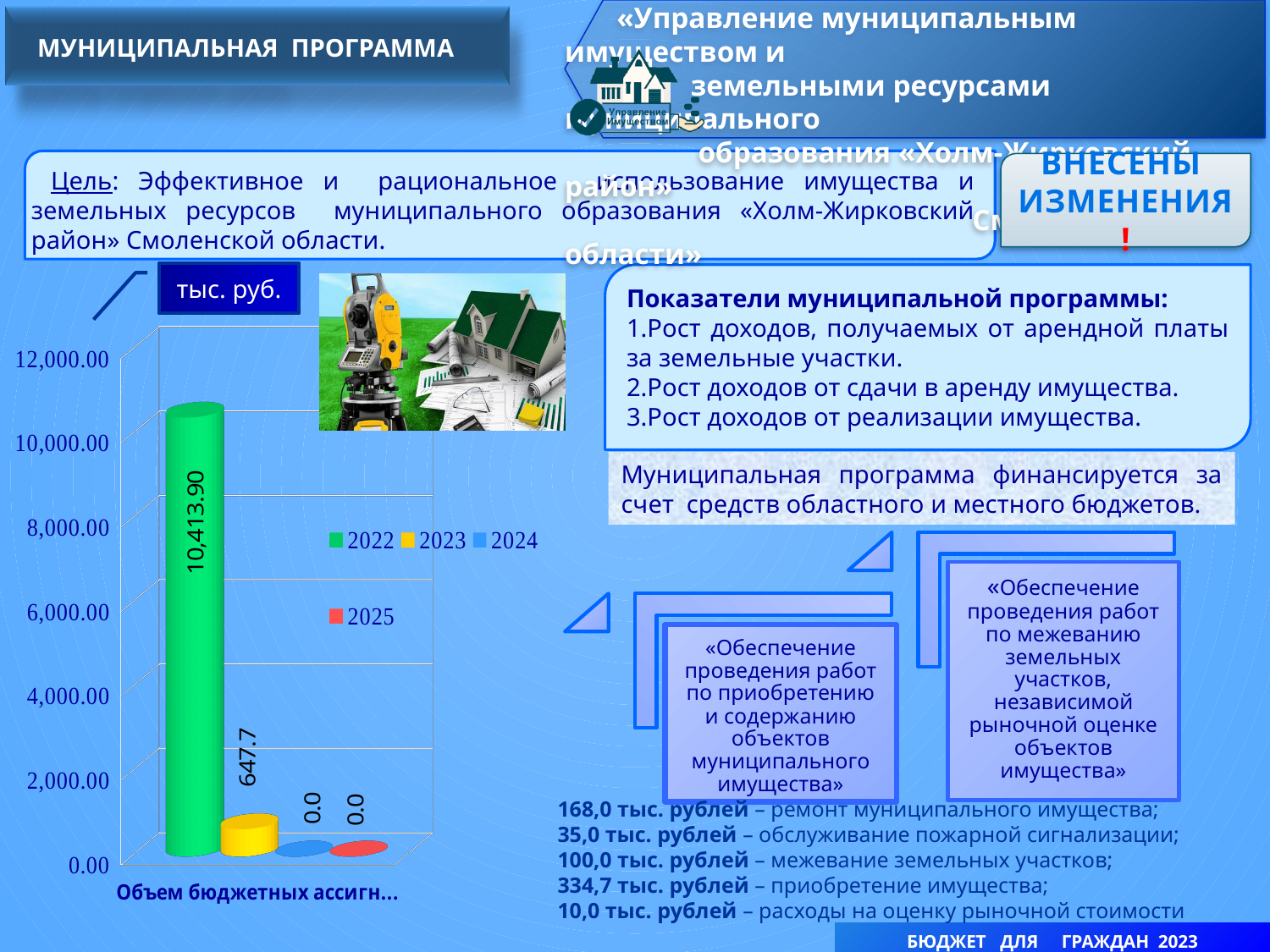
What is the value for the 2023 series in the chart? 647.7 What is the value for the 2024 series in the chart? 0.0 Which is larger in the chart, the value for 2022 or the value for 2023? 2022 Which series has the highest value in the chart? 2022 How many series does the chart legend list? 4 Is the value for 2022 in the chart greater or less than 10,000.00? greater What colour is the bar for the 2022 series in the chart? green Is the value for 2023 in the chart greater or less than 2,000.00? less What is the value for the 2022 series in the chart? 10,413.90 What type of chart is shown on the slide? bar chart What unit is shown in the label above the chart? тыс. руб. What is the value for the 2025 series in the chart? 0.0